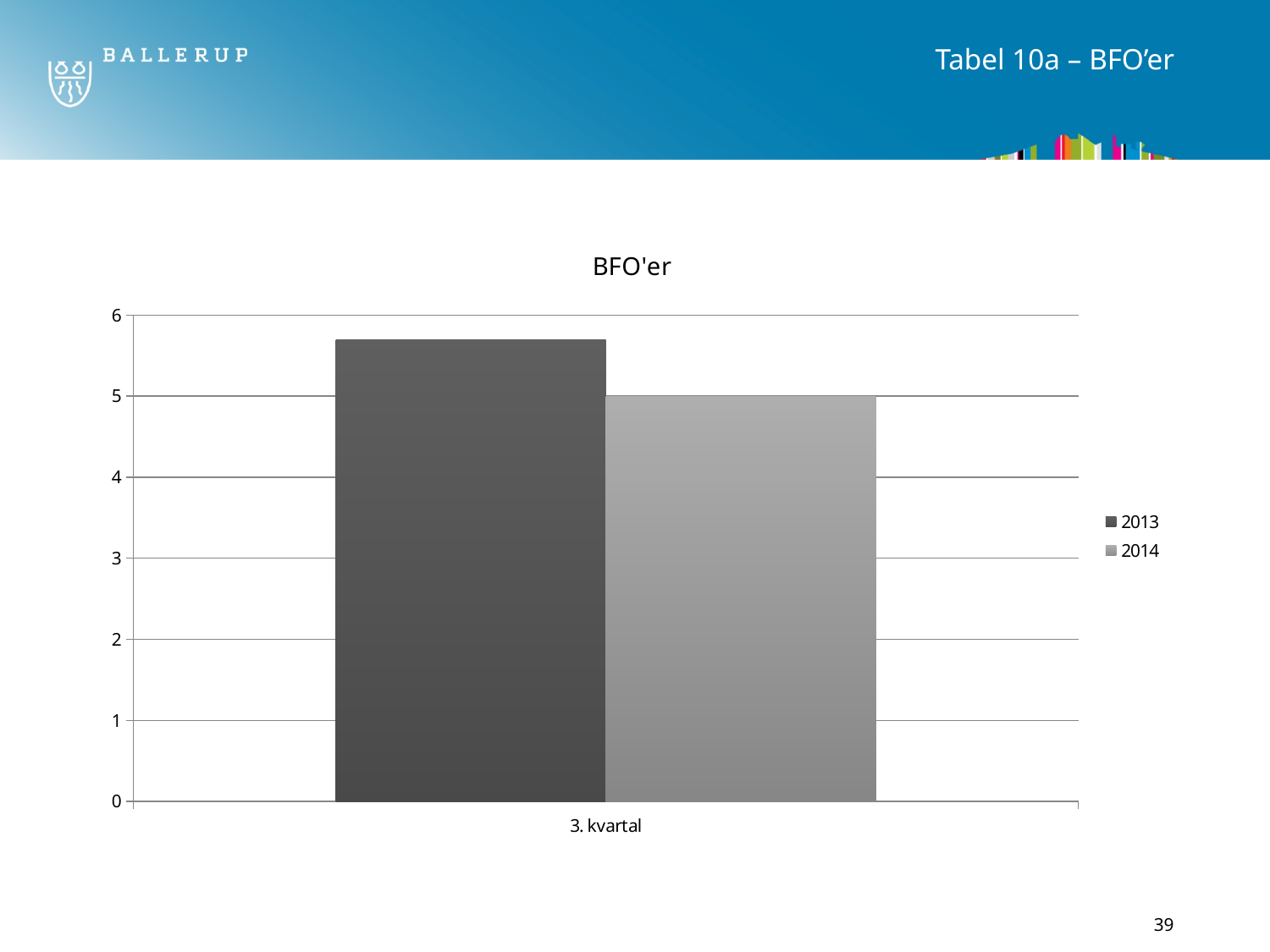
Which series has the lowest value in 3. kvartal? 2014 What is the category label on the x axis? 3. kvartal Which series does the legend list? 2013 and 2014 What is the maximum value shown on the y axis? 6 Is the value for 2013 in 3. kvartal greater or less than 5? greater Which series has the higher value in 3. kvartal, 2013 or 2014? 2013 What is the title of the chart? BFO'er What is the value for 2014 in 3. kvartal? 5 What kind of chart is shown on the slide? bar chart How many series does the legend list? 2 Is the value for 2013 in 3. kvartal greater or less than 6? less How many categories are shown on the x axis? 1